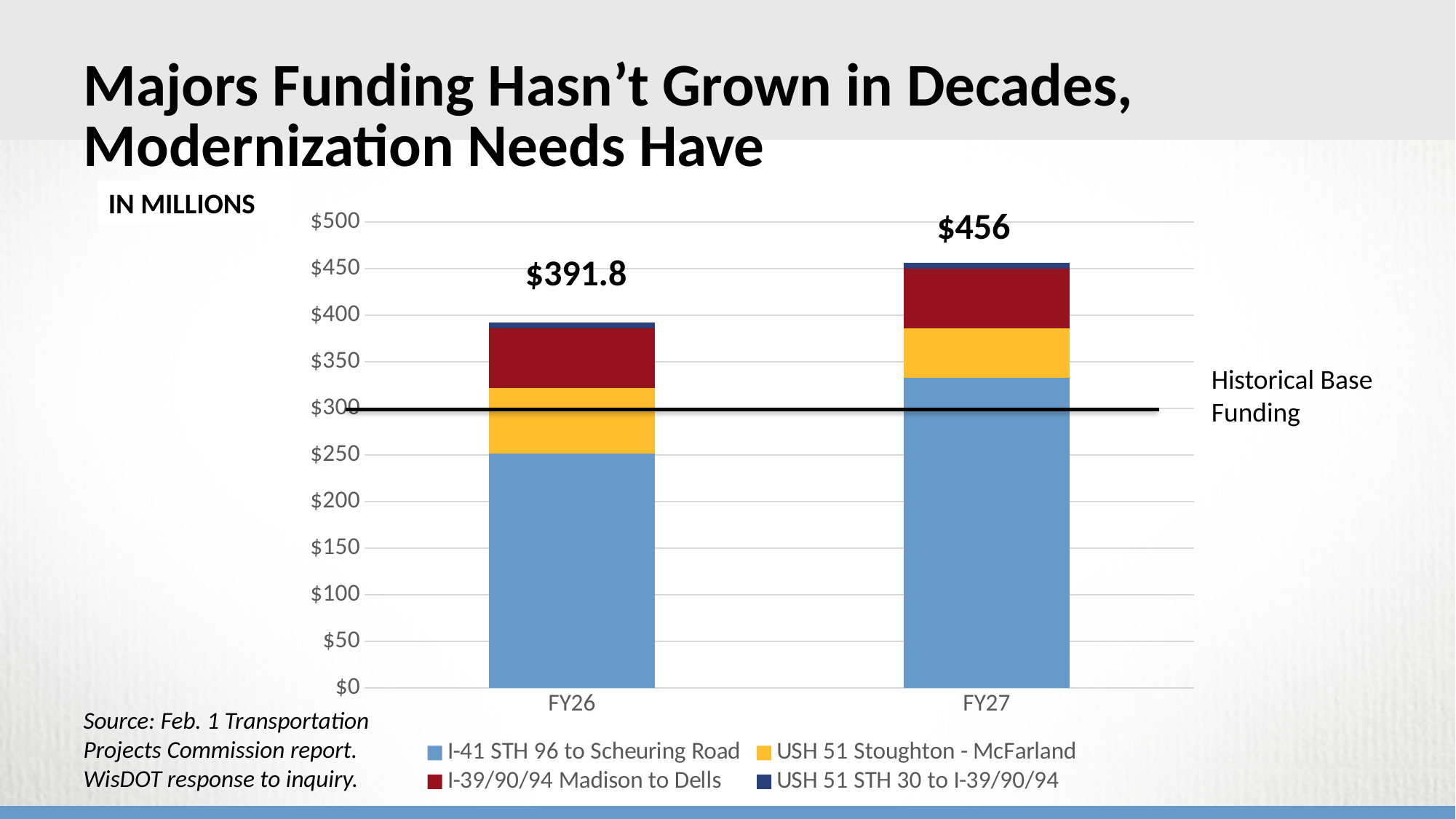
What is the difference between the FY27 total and the FY26 total? $64.2 Is the value for I-41 STH 96 to Scheuring Road in FY27 greater or less than $300? greater Is the value for I-41 STH 96 to Scheuring Road in FY26 greater or less than $300? less Which fiscal year has the highest total bar? FY27 What is the total value labeled above the FY27 bar? $456 Which fiscal year has the larger total, FY26 or FY27? FY27 What kind of chart is shown on the slide? bar chart At what y-axis value is the Historical Base Funding line drawn? $300 How many fiscal years (categories) are plotted on the x axis? 2 Do the total values rise or fall from FY26 to FY27? rise How many series does the legend list? 4 What is the total value labeled above the FY26 bar? $391.8